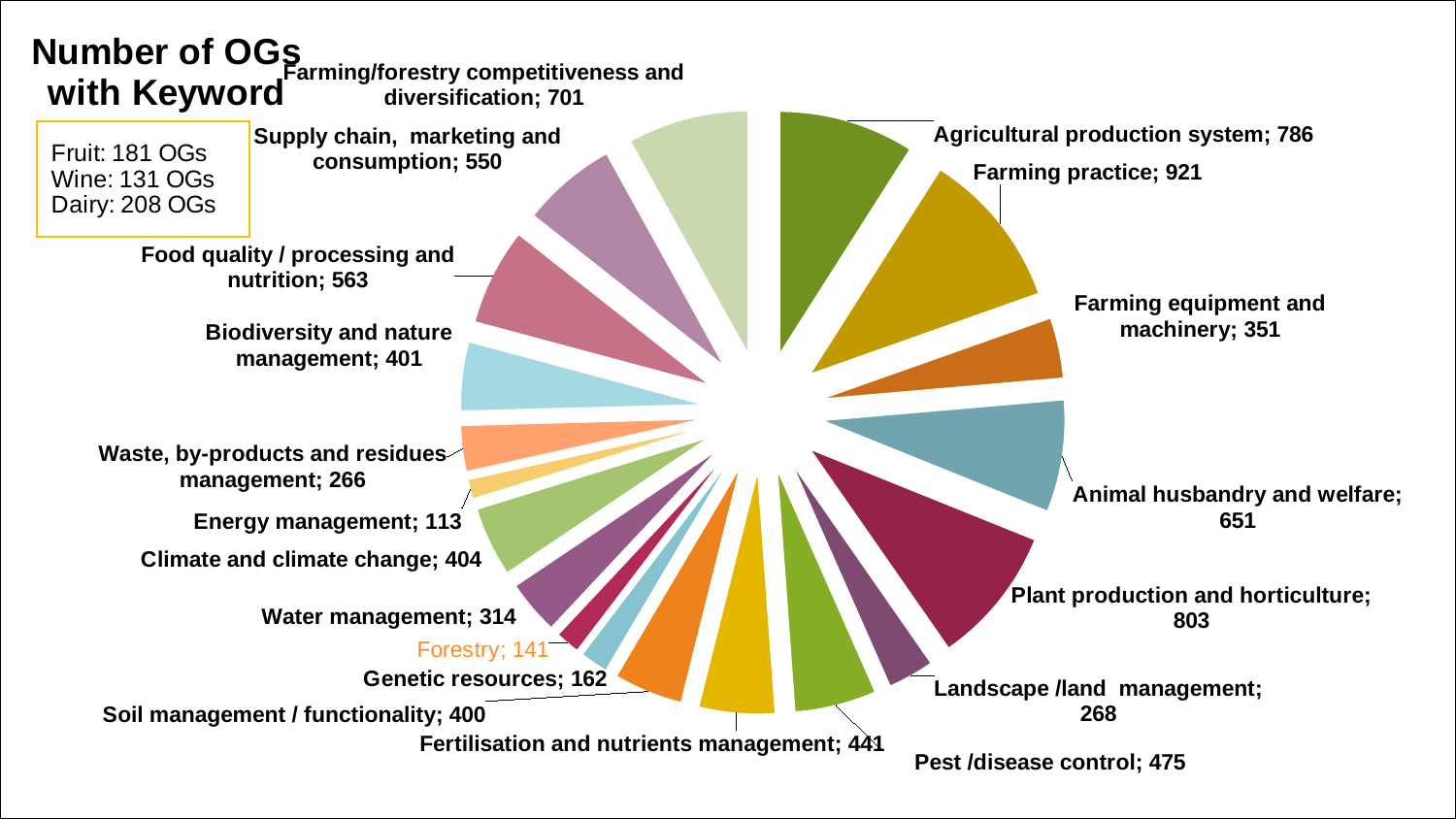
What kind of chart is shown on the slide? pie chart What is the value for 'Forestry'? 141 What is the difference between 'Farming practice' and 'Agricultural production system'? 135 Which keyword has the lowest number of OGs? Energy management How many OGs have the keyword 'Farming practice'? 921 How many slices does the pie chart have? 19 Which keyword has the highest number of OGs? Farming practice What is the title of the chart? Number of OGs with Keyword What is the difference between 'Plant production and horticulture' and 'Animal husbandry and welfare'? 152 What is the value for 'Supply chain, marketing and consumption'? 550 Which is larger, 'Pest /disease control' or 'Fertilisation and nutrients management'? Pest /disease control What is the value for 'Animal husbandry and welfare'? 651